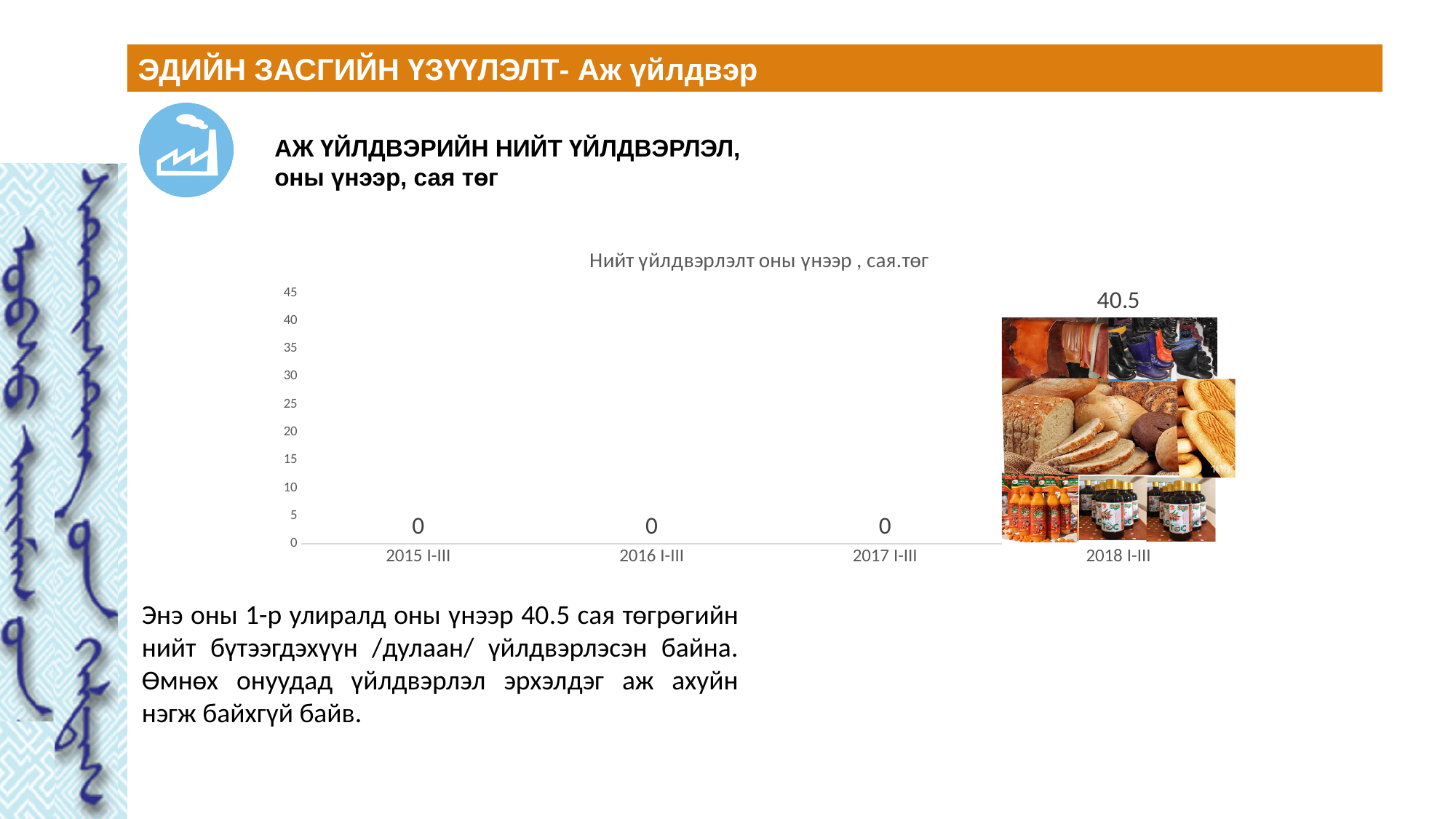
What is the value for 2015 I-III? 0 Which is larger, the value for 2016 I-III or the value for 2018 I-III? 2018 I-III What is the difference between the values for 2018 I-III and 2017 I-III? 40.5 What is the value for 2018 I-III? 40.5 Is the value for 2018 I-III greater or less than 40? greater Which category has the highest value? 2018 I-III What is the title of the chart? Нийт үйлдвэрлэлт оны үнээр , сая.төг How many categories are shown on the x axis? 4 What is the highest value shown on the y axis? 45 Do the values rise or fall from 2017 I-III to 2018 I-III? rise What is the value for 2017 I-III? 0 What kind of chart is shown on the slide? bar chart